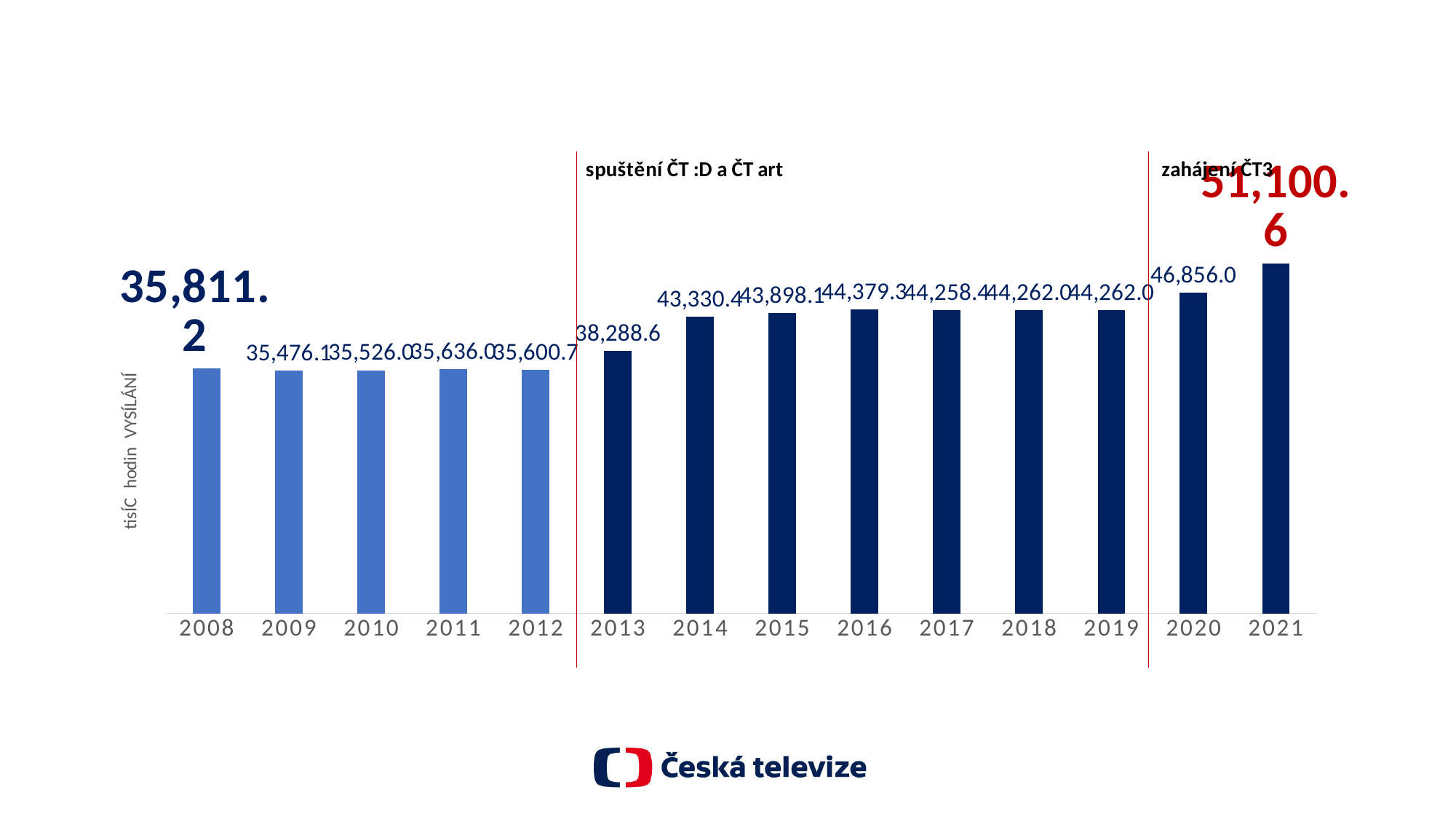
Which year has the highest value? 2021 What is the value for 2013? 38,288.6 What is the value for 2020? 46,856.0 What is the label on the vertical axis? tisíc hodin VYSÍLÁNÍ What kind of chart is shown on the slide? Bar chart What is the value for 2021? 51,100.6 How many years are shown on the x axis? 14 What is the difference between the values for 2013 and 2012? 2,687.9 What is the difference between the values for 2021 and 2020? 4,244.6 Which year has the lowest value? 2009 What is the value for 2008? 35,811.2 Which is larger, the value for 2014 or the value for 2015? 2015